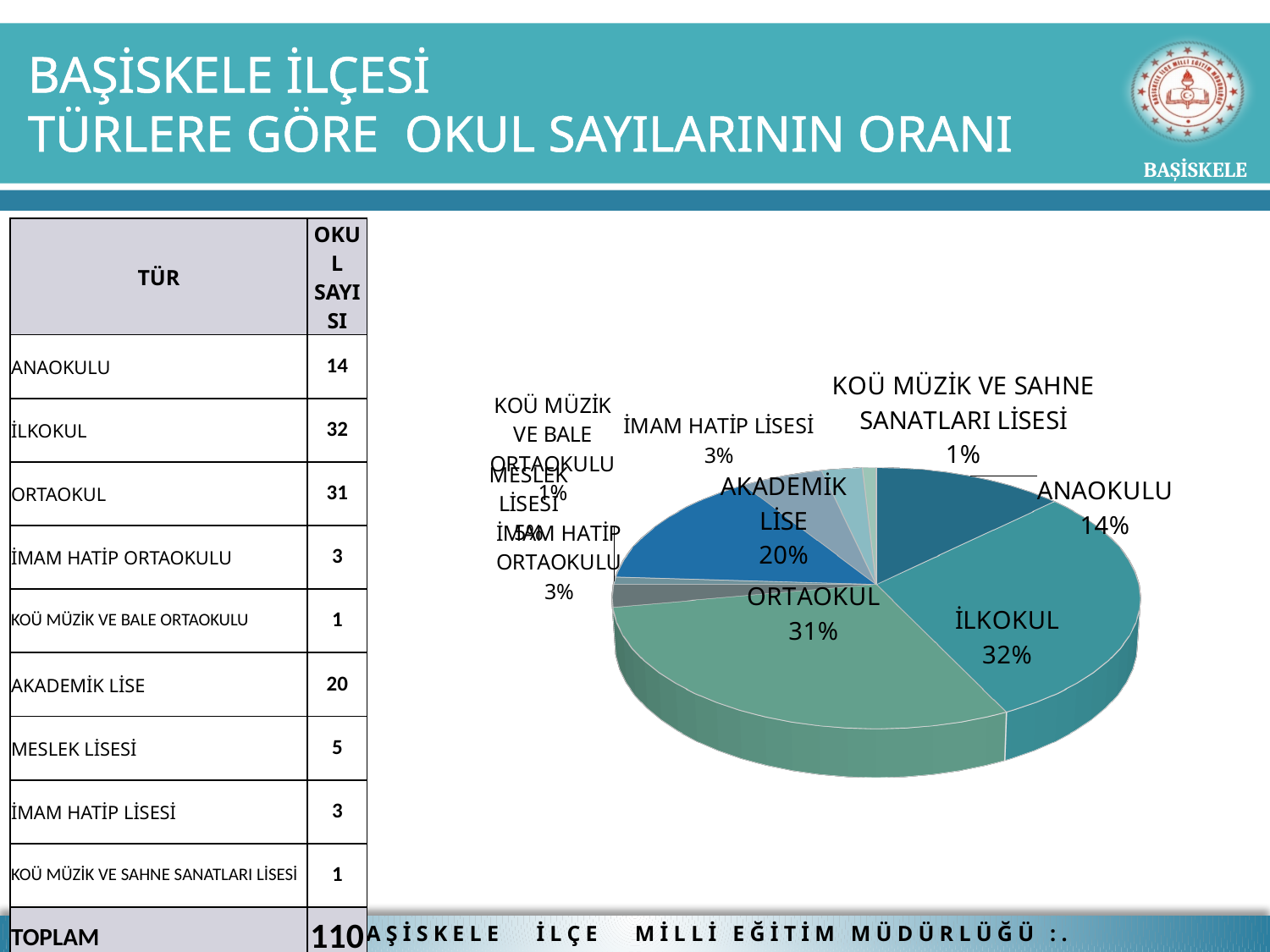
What kind of chart is shown on the slide? pie chart What is the value shown for AKADEMİK LİSE in the pie chart? 20% What is the value shown for ANAOKULU in the pie chart? 14% What share of the pie does ORTAOKUL have? 31% Which is larger in the pie chart, AKADEMİK LİSE or ANAOKULU? AKADEMİK LİSE What share of the pie does İLKOKUL have? 32% Which is larger in the pie chart, ORTAOKUL or AKADEMİK LİSE? ORTAOKUL How many slices does the pie chart have? 9 What is the value shown for KOÜ MÜZİK VE SAHNE SANATLARI LİSESİ in the pie chart? 1% What is the difference in percentage points between İLKOKUL and ANAOKULU in the pie chart? 18% What is the value shown for İMAM HATİP LİSESİ in the pie chart? 3% Which category has the largest slice of the pie? İLKOKUL